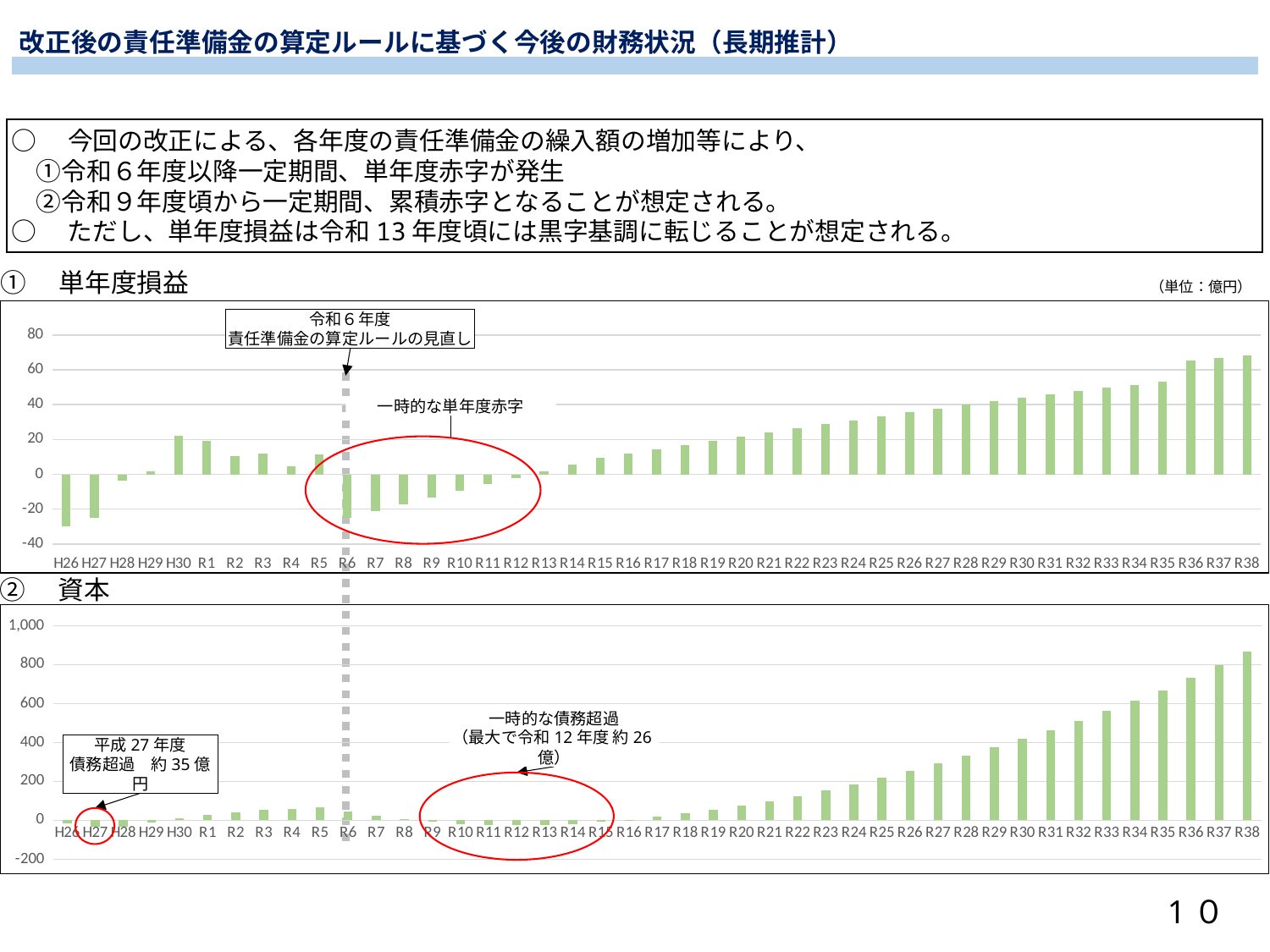
What kind of chart is the ① 単年度損益 chart? bar chart What unit is stated for the charts on the slide? 億円 In the ② 資本 chart, is the value for R33 greater or less than 600? less In the ② 資本 chart, which fiscal year has the highest value? R38 In the ② 資本 chart, which is larger, the value for R36 or the value for R30? R36 In the ② 資本 chart, do the values rise or fall from R16 to R38? rise In the ① 単年度損益 chart, is the value for H26 greater or less than -20? less How many categories (fiscal years) are shown on the x axis of the ② 資本 chart? 43 In the ① 単年度損益 chart, which fiscal year has the highest value? R38 In the ① 単年度損益 chart, is the value for R38 greater or less than 60? greater